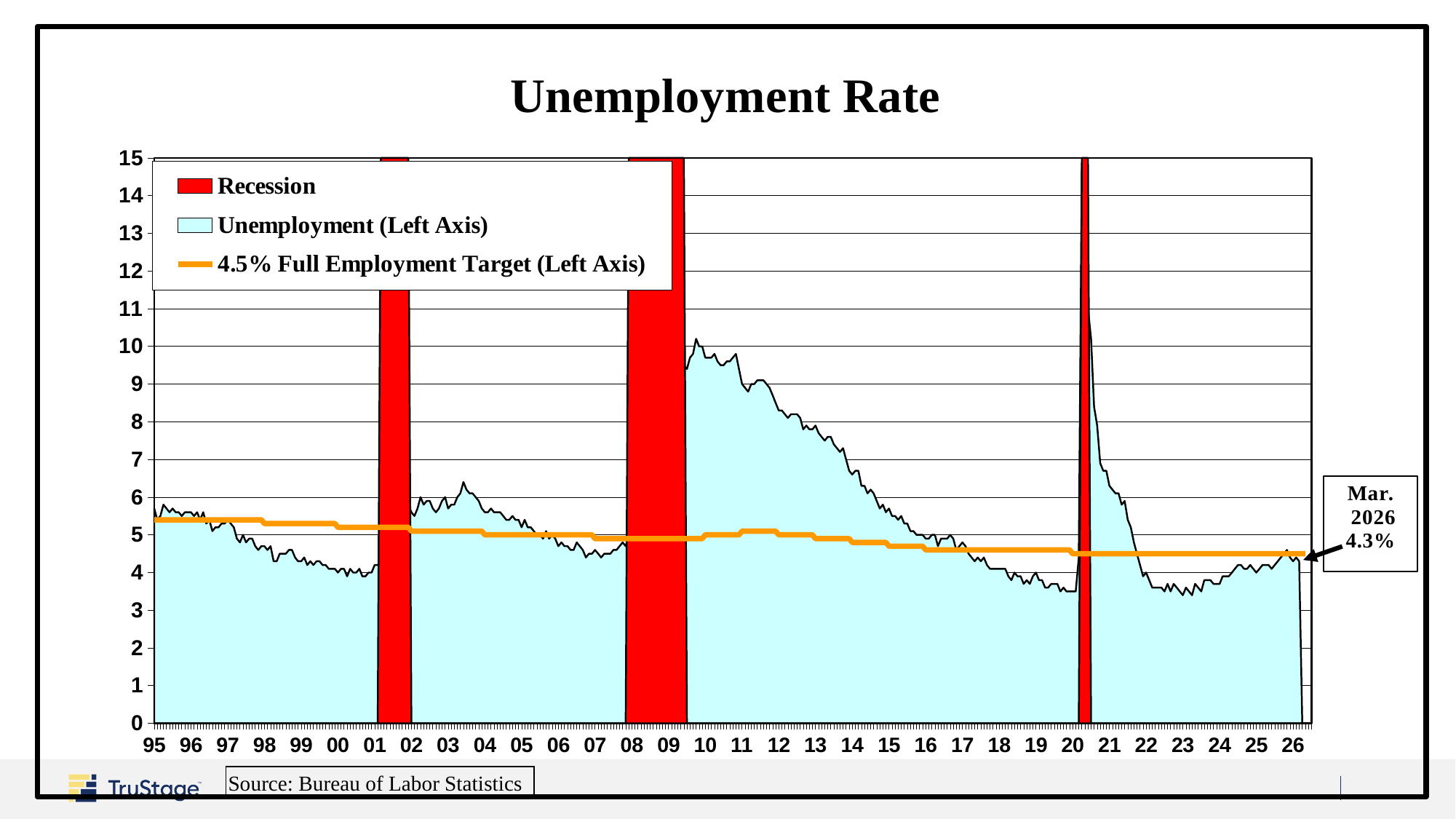
Is the unemployment rate in 2023 greater or less than 4? less What unemployment rate is annotated for Mar. 2026? 4.3% How many recession periods are shaded on the chart? 3 What is the title of the chart? Unemployment Rate Does the unemployment rate rise or fall from 2010 to 2019? fall Which is higher, the unemployment rate in 2010 or in 2000? 2010 Is the unemployment rate in 2000 greater or less than 5? less What kind of chart is used to show the unemployment rate? area chart How many entries does the chart legend list? 3 Is the unemployment rate in 2010 greater or less than 8? greater Which year shows the highest peak in the unemployment rate? 2020 What is the full employment target rate shown on the chart? 4.5%